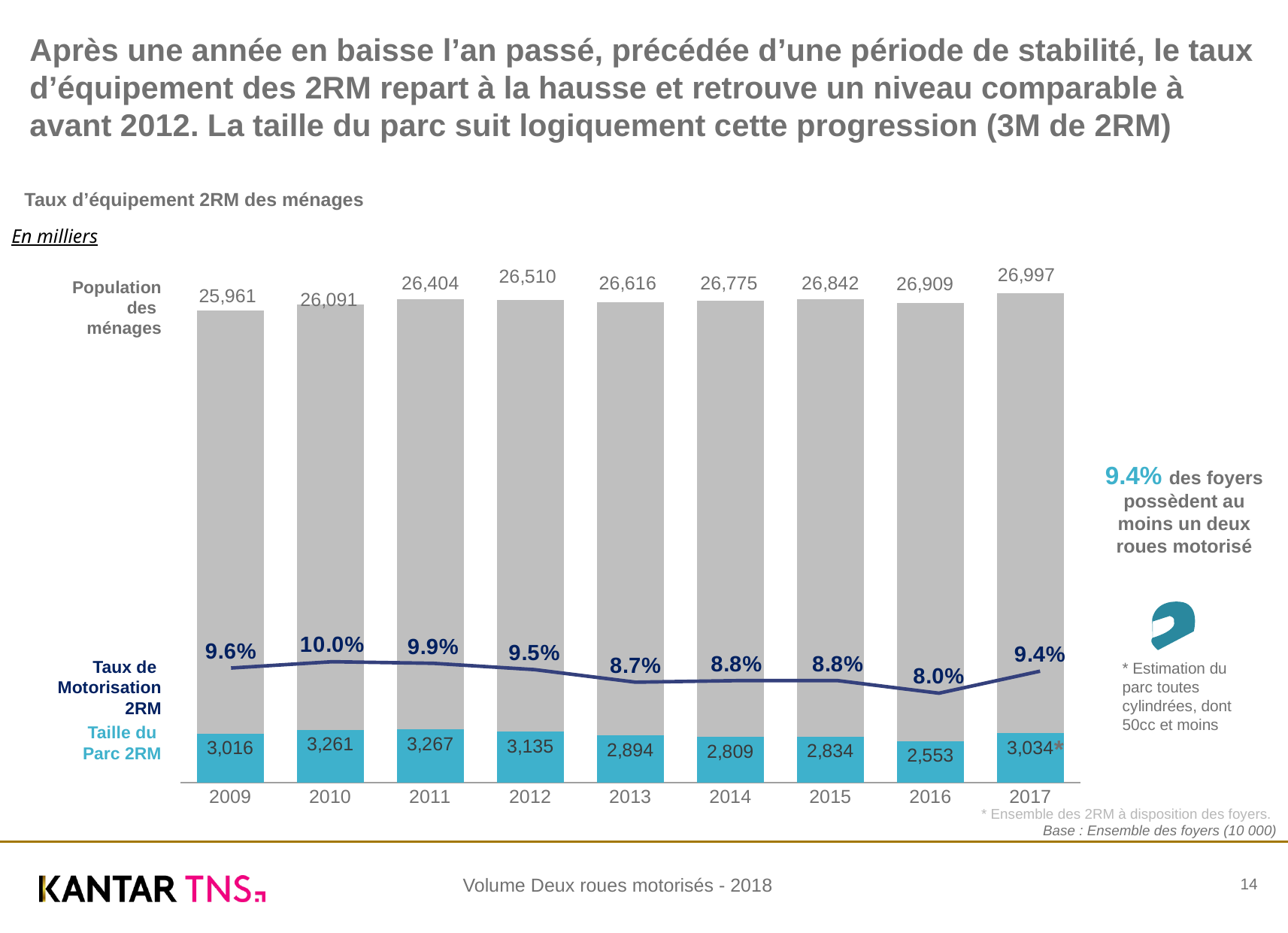
What is the difference in Taux de Motorisation 2RM between 2010 and 2016? 2.0% What is the value of Population des ménages for 2017? 26,997 In which year is the Taille du Parc 2RM lowest? 2016 What is the title of the chart? Taux d'équipement 2RM des ménages How many years are shown on the x axis of the chart? 9 In which year is the Taux de Motorisation 2RM highest? 2010 Which year has a larger Taille du Parc 2RM, 2012 or 2017? 2012 What is the difference in Population des ménages between 2017 and 2009? 1,036 What is the Taux de Motorisation 2RM for 2016? 8.0% What kind of chart is used to show Population des ménages and Taille du Parc 2RM? Bar chart What is the Taille du Parc 2RM value for 2011? 3,267 Does the Population des ménages rise or fall from 2009 to 2017? Rise